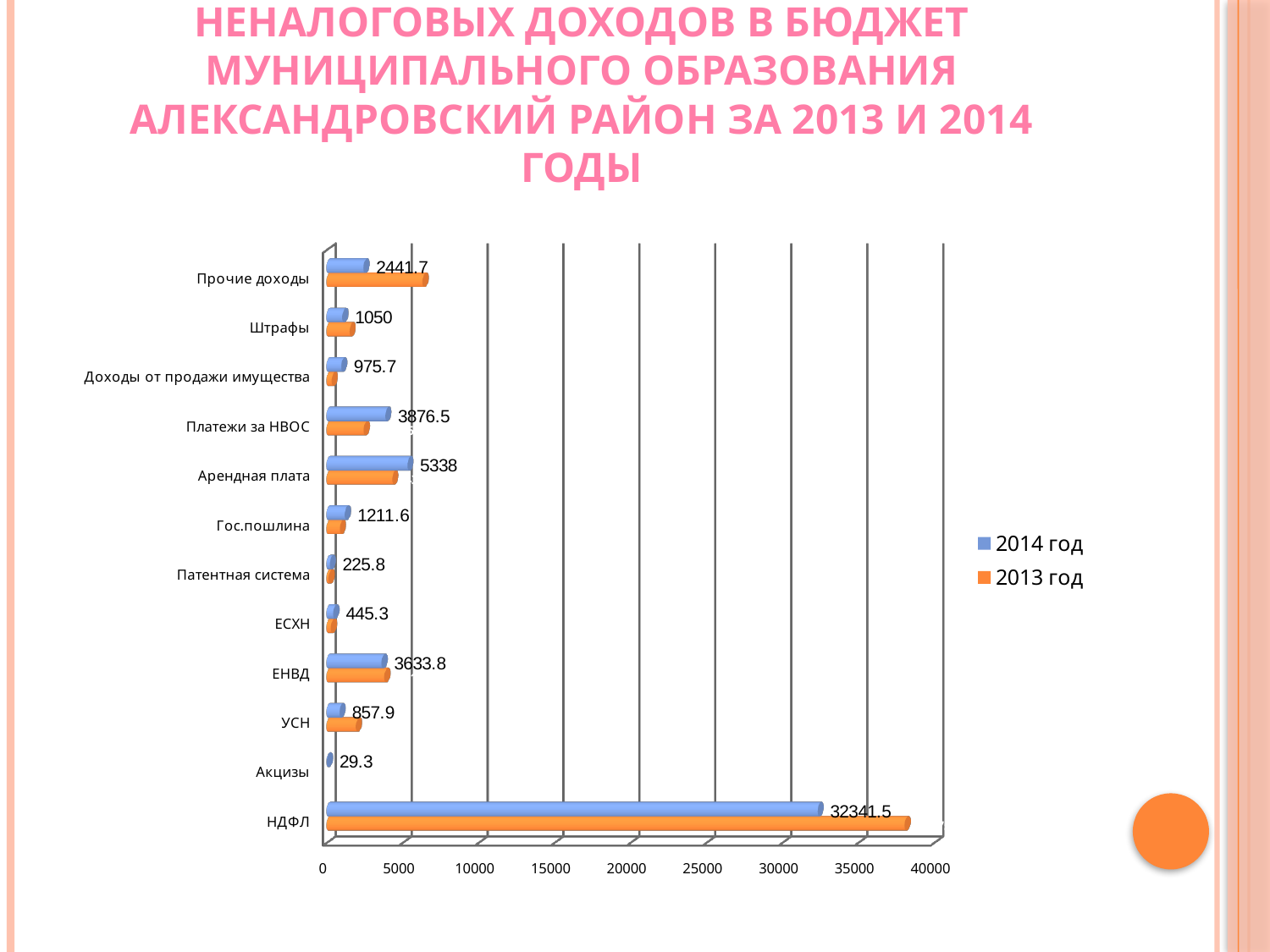
Which category has the lowest 2014 год value? Акцизы What is the 2014 год value for Платежи за НВОС? 3876.5 How many series does the legend list? 2 Which has the larger 2014 год value, ЕНВД or Гос.пошлина? ЕНВД Is the 2013 год value for НДФЛ greater or less than 35000? greater How many categories are shown on the chart? 12 What kind of chart is shown on the slide? bar chart What is the difference between the 2014 год values for Арендная плата and Платежи за НВОС? 1461.5 Which category has the highest 2014 год value? НДФЛ What is the 2014 год value for Акцизы? 29.3 What is the 2014 год value for Арендная плата? 5338 What is the 2014 год value for НДФЛ? 32341.5